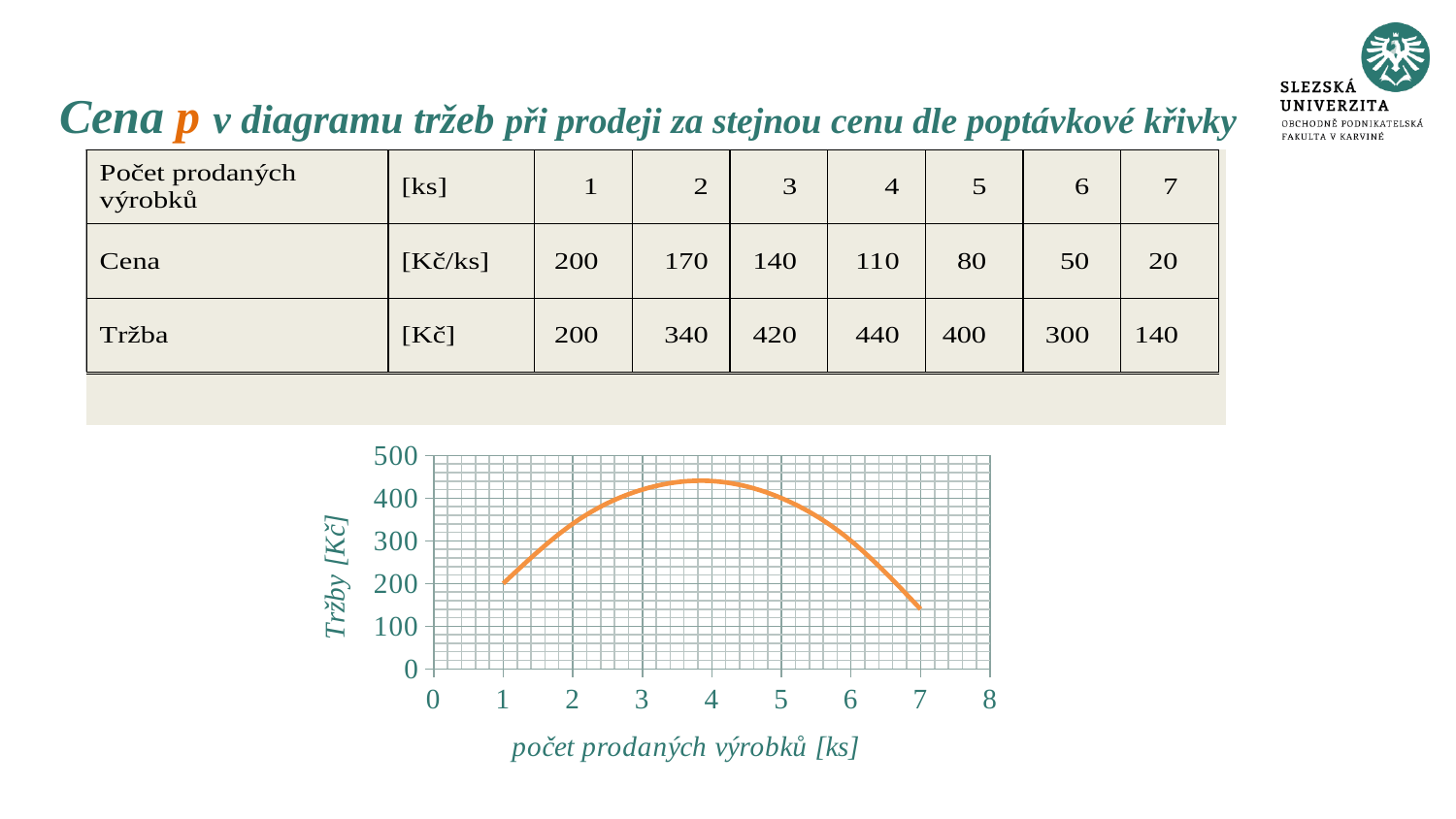
Is the revenue for 7 units sold greater or less than 200? less What is the label of the vertical axis of the chart? Tržby [Kč] What is the revenue (Tržba) when 1 unit is sold? 200 Is the revenue for 3 units sold greater or less than 400? greater What is the difference between the revenue for 4 units sold and the revenue for 7 units sold? 300 What is the revenue (Tržba) when 5 units are sold? 400 At how many units sold is the revenue (Tržba) lowest? 7 Which is larger, the revenue for 2 units sold or for 6 units sold? 2 units sold What is the revenue (Tržba) when 4 units are sold? 440 What kind of chart is shown on the slide? line chart At how many units sold (počet prodaných výrobků) does the revenue curve reach its highest value? 4 What is the label of the horizontal axis of the chart? počet prodaných výrobků [ks]